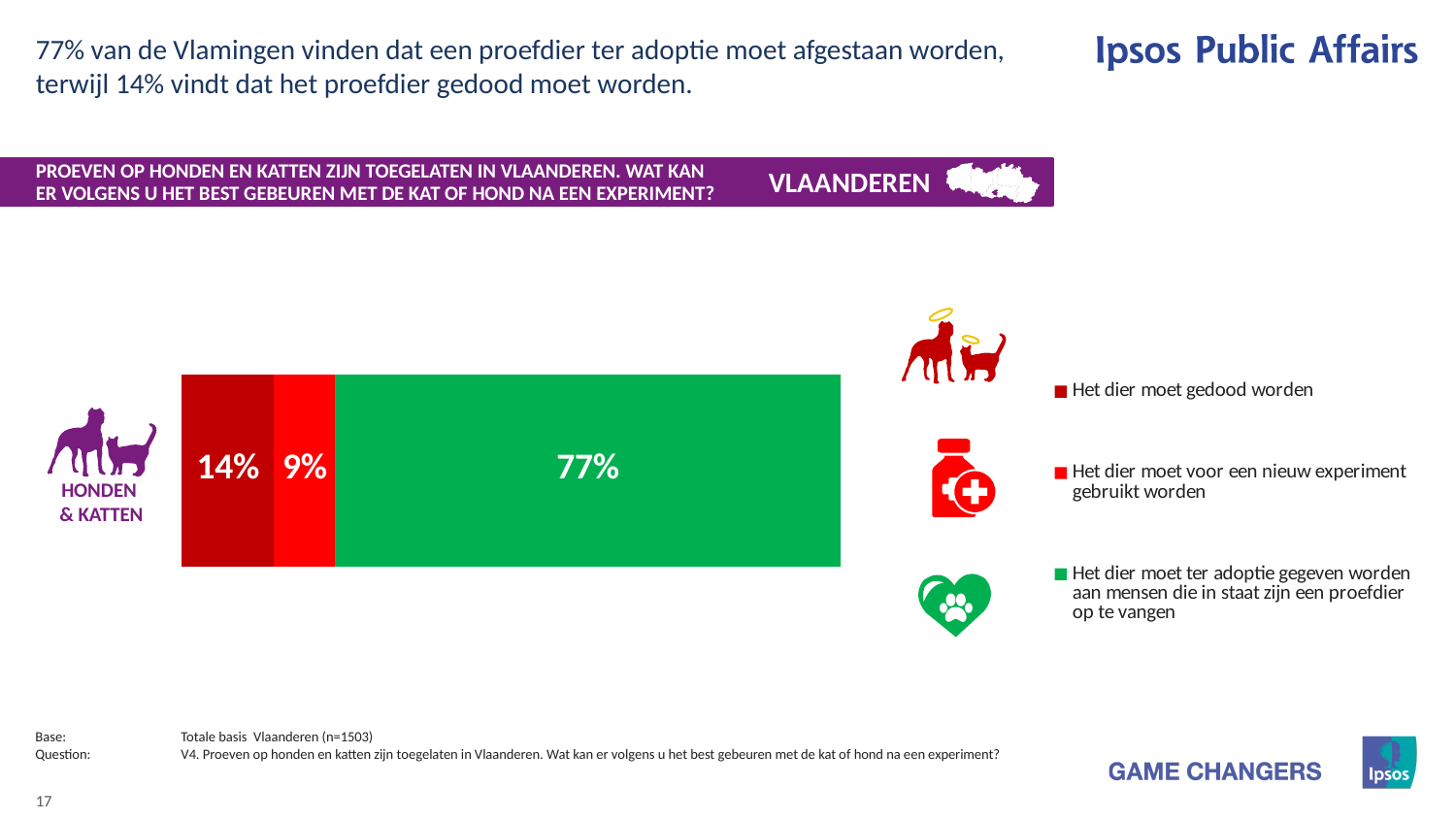
What percentage of respondents chose "Het dier moet ter adoptie gegeven worden aan mensen die in staat zijn een proefdier op te vangen"? 77% How many series does the legend list? 3 What is the difference in percentage points between "Het dier moet ter adoptie gegeven worden" and "Het dier moet gedood worden"? 63 What kind of chart is shown on the slide? Stacked bar chart What is the total of the three segments in the stacked bar? 100% What is the difference in percentage points between "Het dier moet gedood worden" and "Het dier moet voor een nieuw experiment gebruikt worden"? 5 What percentage of respondents chose "Het dier moet voor een nieuw experiment gebruikt worden"? 9% Which answer option has the smallest share in the bar? Het dier moet voor een nieuw experiment gebruikt worden What percentage of respondents chose "Het dier moet gedood worden"? 14% Which is larger: the share for "Het dier moet gedood worden" or the share for "Het dier moet voor een nieuw experiment gebruikt worden"? Het dier moet gedood worden Which colour represents "Het dier moet ter adoptie gegeven worden" in the chart? Green Which answer option has the largest share in the bar? Het dier moet ter adoptie gegeven worden aan mensen die in staat zijn een proefdier op te vangen